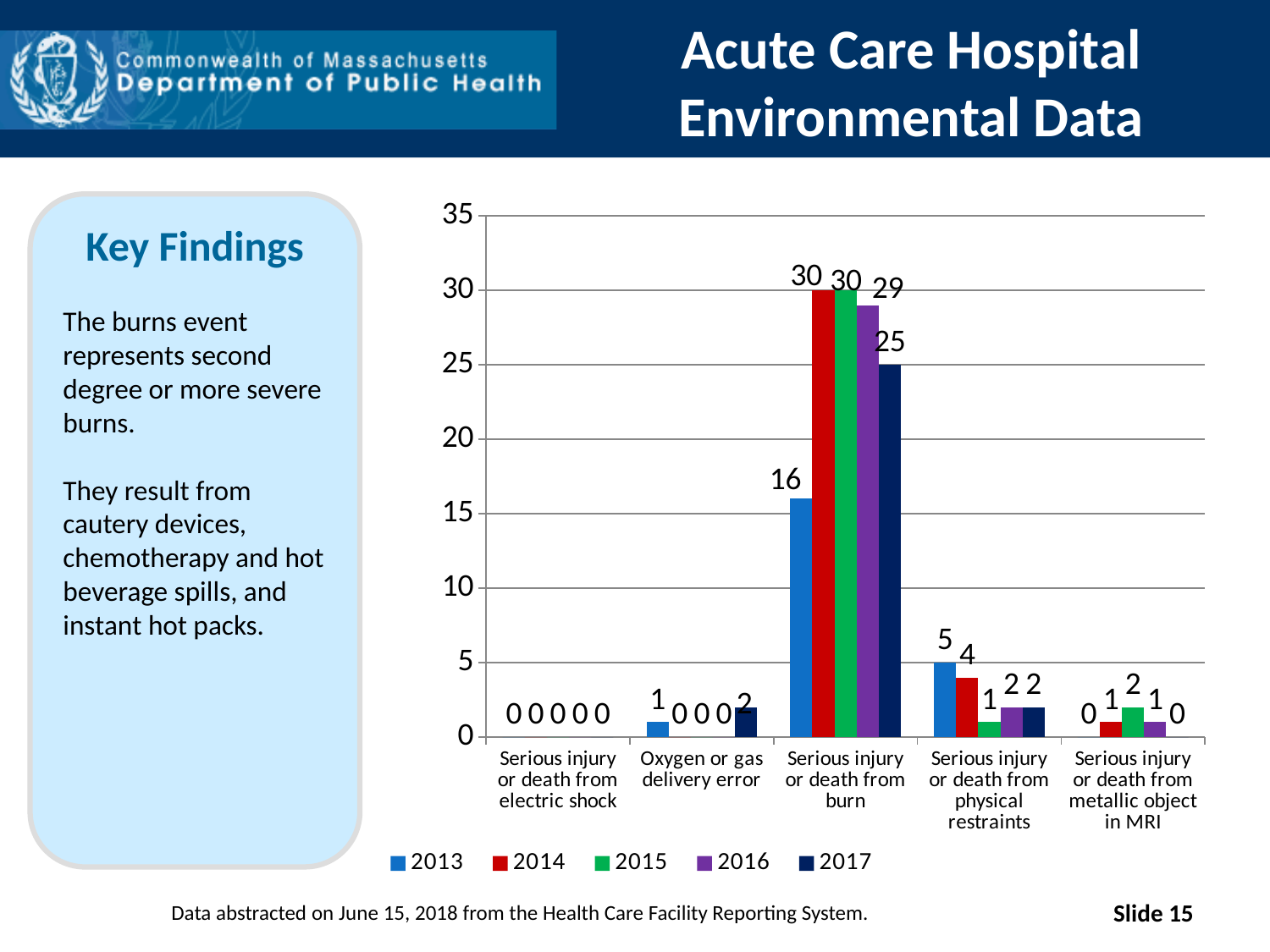
What kind of chart is shown on the slide? Bar chart How many categories are shown on the x axis? 5 What is the value for Serious injury or death from burn in 2013? 16 What is the value for Oxygen or gas delivery error in 2017? 2 Which category has the highest value in 2014? Serious injury or death from burn What is the difference between the 2014 and 2013 values for Serious injury or death from burn? 14 Which is larger for Serious injury or death from burn: the 2016 value or the 2017 value? 2016 How many series does the legend list? 5 What is the value for Serious injury or death from physical restraints in 2013? 5 What is the value for Serious injury or death from metallic object in MRI in 2015? 2 What is the value for Serious injury or death from burn in 2017? 25 Which year is shown in red in the legend? 2014